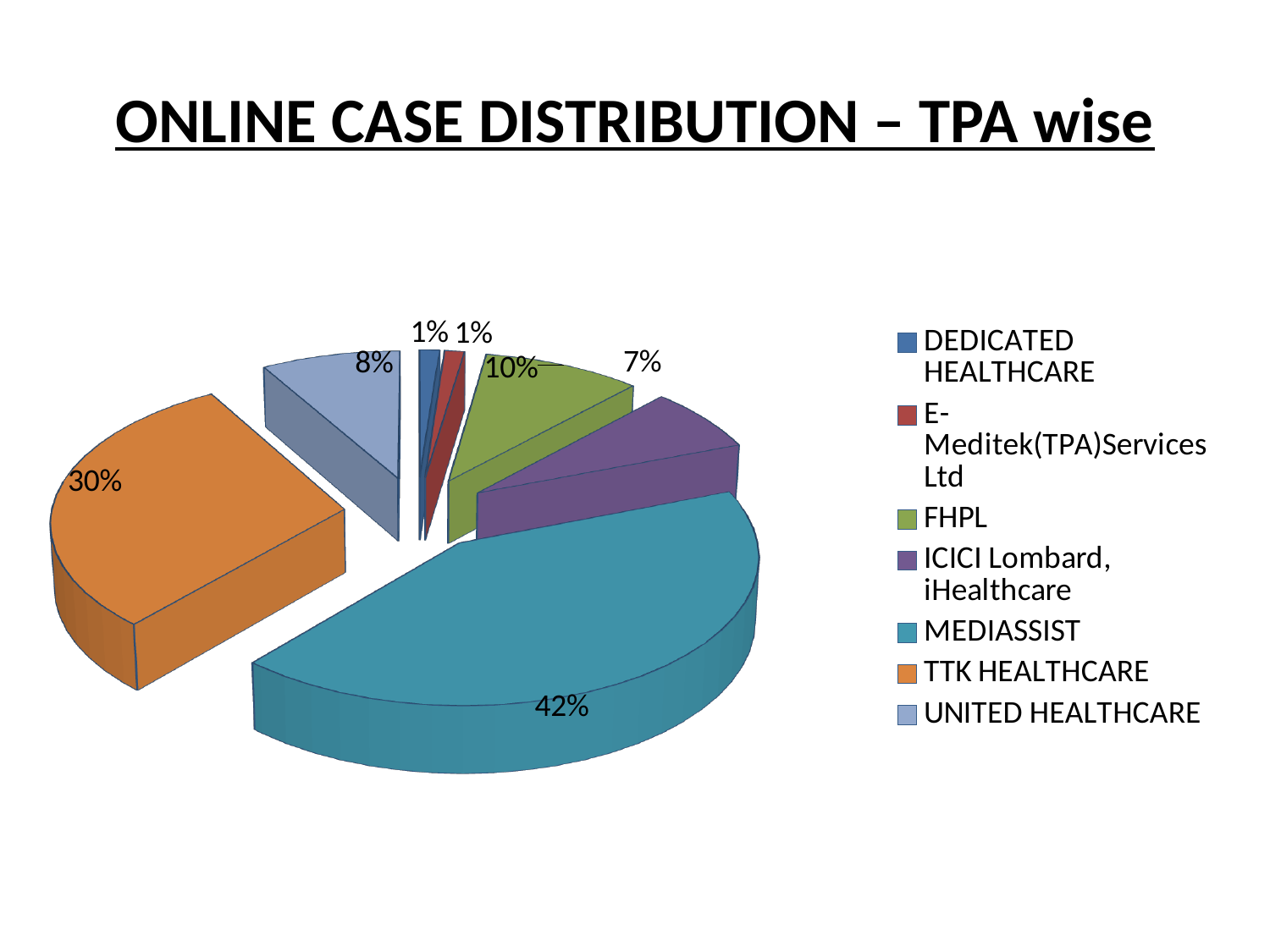
What kind of chart is shown on the slide? pie chart What share of online cases does TTK HEALTHCARE account for? 30% Which TPA has a larger share of online cases, FHPL or UNITED HEALTHCARE? FHPL What share of online cases does FHPL account for? 10% Which TPA is represented by the orange slice? TTK HEALTHCARE What share of online cases does MEDIASSIST account for? 42% What is the title of the slide's chart? ONLINE CASE DISTRIBUTION – TPA wise Which TPA has the largest share of online cases? MEDIASSIST What is the difference in percentage points between the MEDIASSIST share and the TTK HEALTHCARE share? 12 How many TPAs are listed in the legend of the pie chart? 7